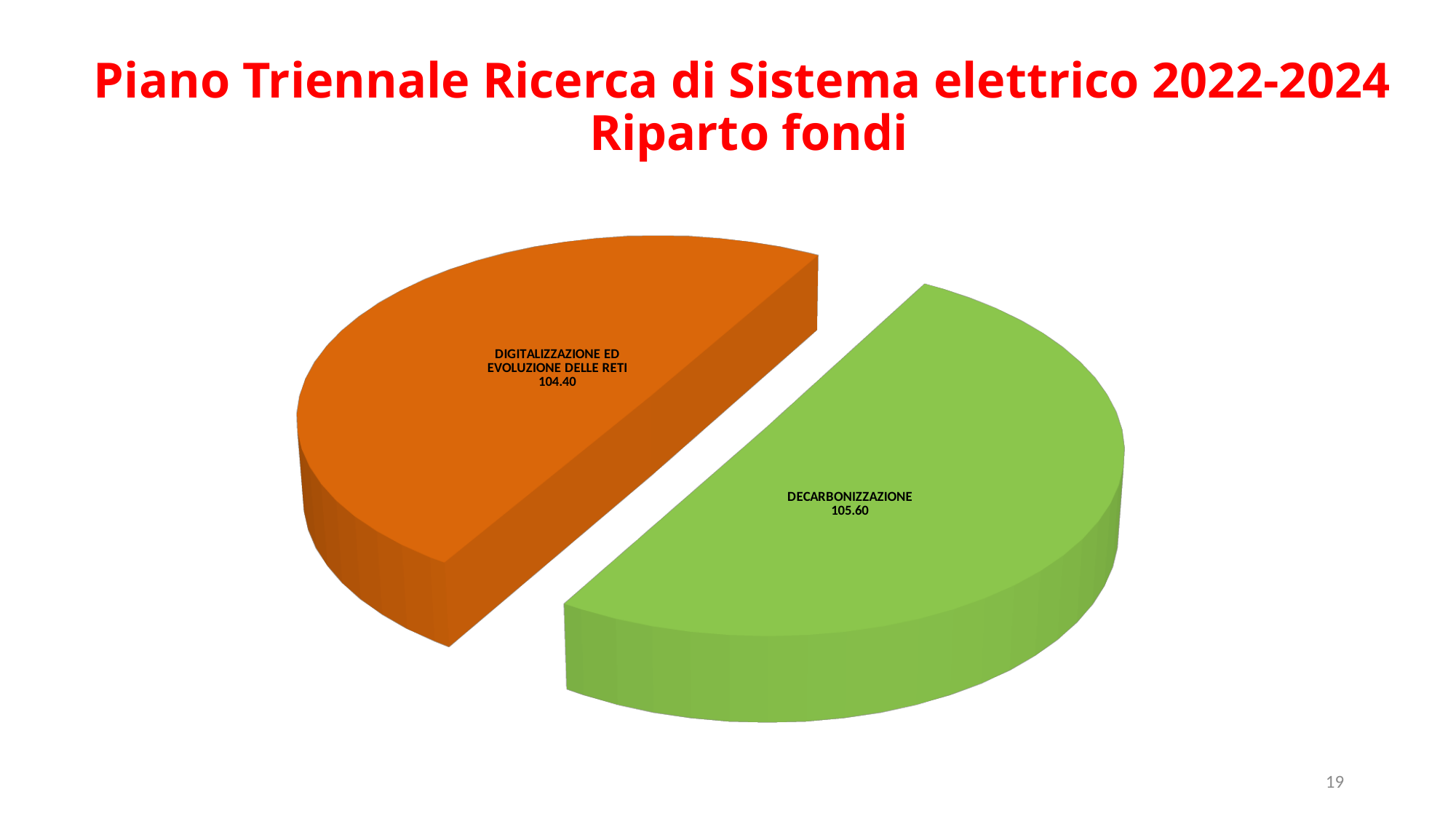
What colour is the DECARBONIZZAZIONE slice? Green What is the title of the slide containing the pie chart? Piano Triennale Ricerca di Sistema elettrico 2022-2024 Riparto fondi Which category has the larger value? DECARBONIZZAZIONE What is the difference between the values for DECARBONIZZAZIONE and DIGITALIZZAZIONE ED EVOLUZIONE DELLE RETI? 1.20 What is the value for DECARBONIZZAZIONE? 105.60 Is the value for DECARBONIZZAZIONE larger or smaller than the value for DIGITALIZZAZIONE ED EVOLUZIONE DELLE RETI? Larger How many slices does the pie chart have? 2 What is the total of the two slices in the pie chart? 210.00 What type of chart is shown on the slide? Pie chart What is the value for DIGITALIZZAZIONE ED EVOLUZIONE DELLE RETI? 104.40 Which category has the smaller value? DIGITALIZZAZIONE ED EVOLUZIONE DELLE RETI